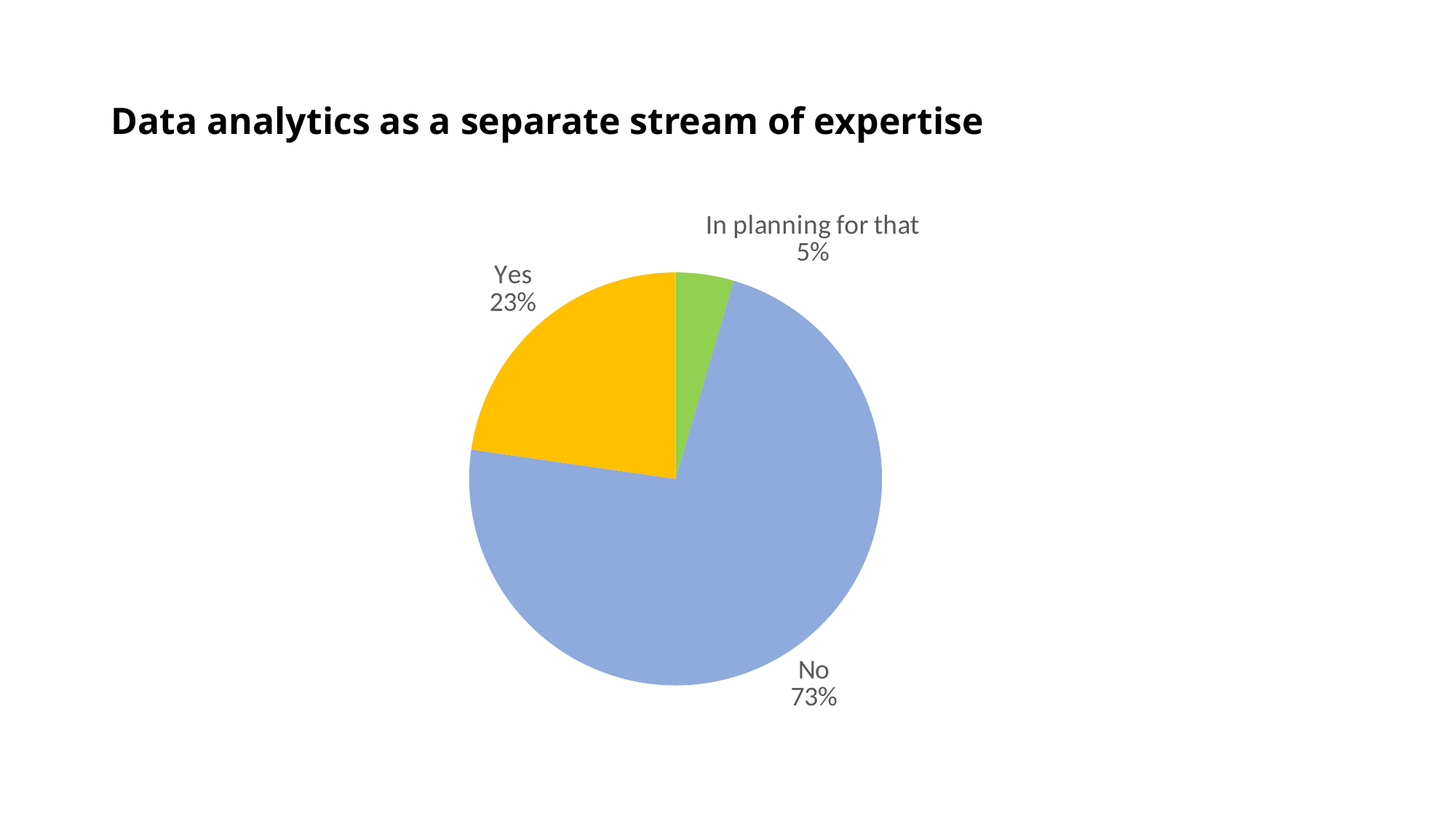
What is the title of the slide? Data analytics as a separate stream of expertise What percentage of the pie is labelled "No"? 73% What percentage of the pie is labelled "Yes"? 23% What kind of chart is shown on the slide? Pie chart Which slice of the pie is the smallest? In planning for that What percentage of the pie is labelled "In planning for that"? 5% What is the difference in percentage points between the "No" slice and the "Yes" slice? 50 Which is larger, the "Yes" slice or the "In planning for that" slice? Yes Which slice of the pie is the largest? No How many slices does the pie chart have? 3 What colour is the "Yes" slice of the pie? Yellow What is the difference in percentage points between the "Yes" slice and the "In planning for that" slice? 18